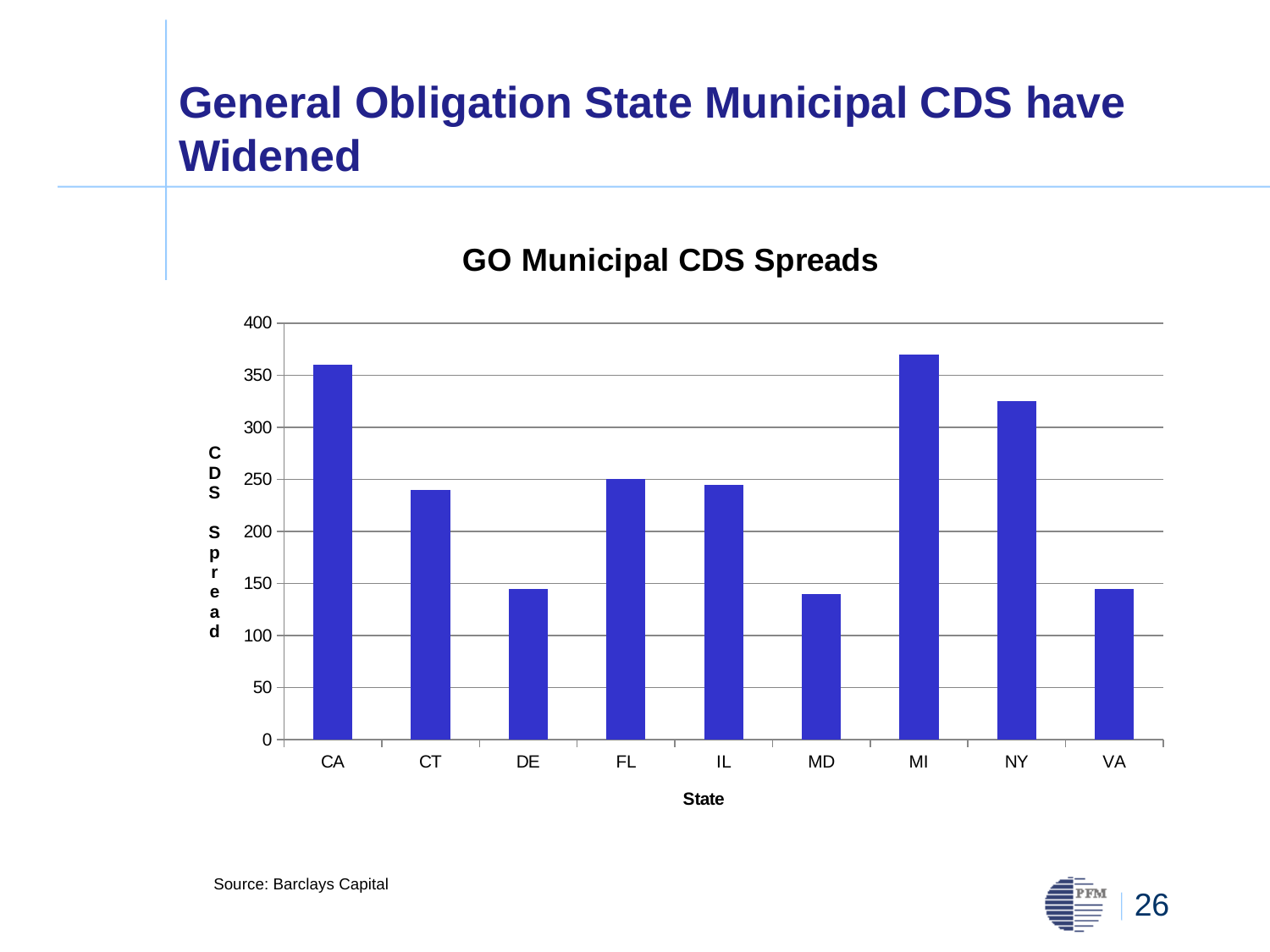
Which state has the larger CDS spread, CA or NY? CA Is the CDS spread for CA greater or less than 350? greater Which state has the larger CDS spread, FL or MD? FL Is the CDS spread for NY greater or less than 300? greater What kind of chart is shown on the slide? bar chart What is the label of the x axis of the chart? State How many states are shown on the x axis of the chart? 9 Is the CDS spread for VA greater or less than 200? less Which state has the highest CDS spread in the chart? MI What is the title of the chart? GO Municipal CDS Spreads